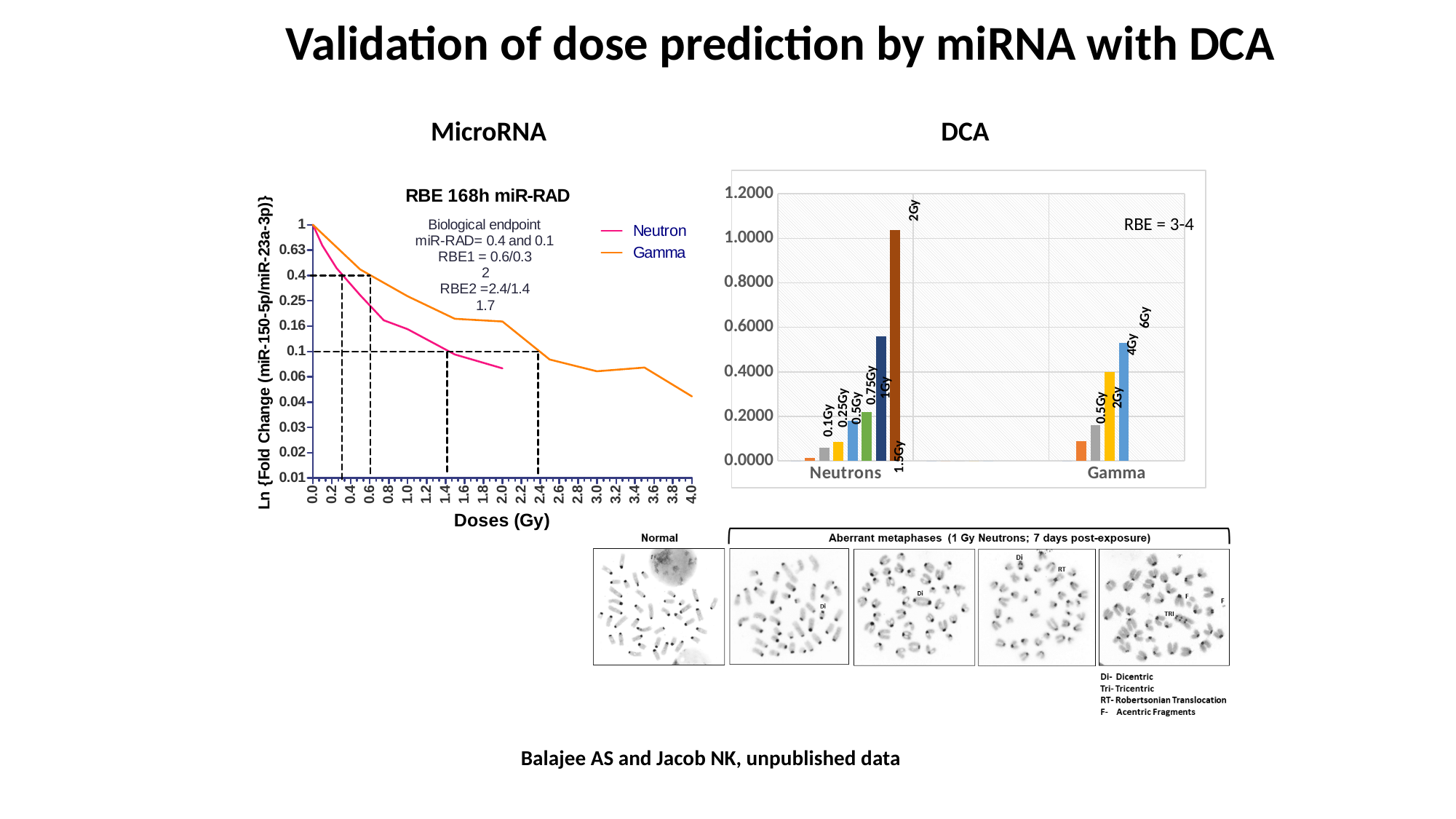
What is the x-axis label of the 'RBE 168h miR-RAD' chart? Doses (Gy) In the DCA bar chart, is the value for the 1Gy Neutrons bar greater or less than 0.6000? less In the DCA bar chart, which bar is the highest? 2Gy (Neutrons) What type of chart is the MicroRNA chart titled 'RBE 168h miR-RAD'? line chart In the DCA bar chart, is the value for the 2Gy Neutrons bar greater or less than 1.0000? greater In the 'RBE 168h miR-RAD' chart, at a dose of 1.0 Gy, which series has the higher fold change, Neutron or Gamma? Gamma How many series does the legend of the 'RBE 168h miR-RAD' chart list? 2 What type of chart is the DCA chart on the right? bar chart In the 'RBE 168h miR-RAD' chart, do the Neutron and Gamma values rise or fall as dose increases? fall In the 'RBE 168h miR-RAD' chart, which series is shown in orange? Gamma In the DCA bar chart, how many bars are in the Neutrons group? 7 In the DCA bar chart, how many bars are in the Gamma group? 4